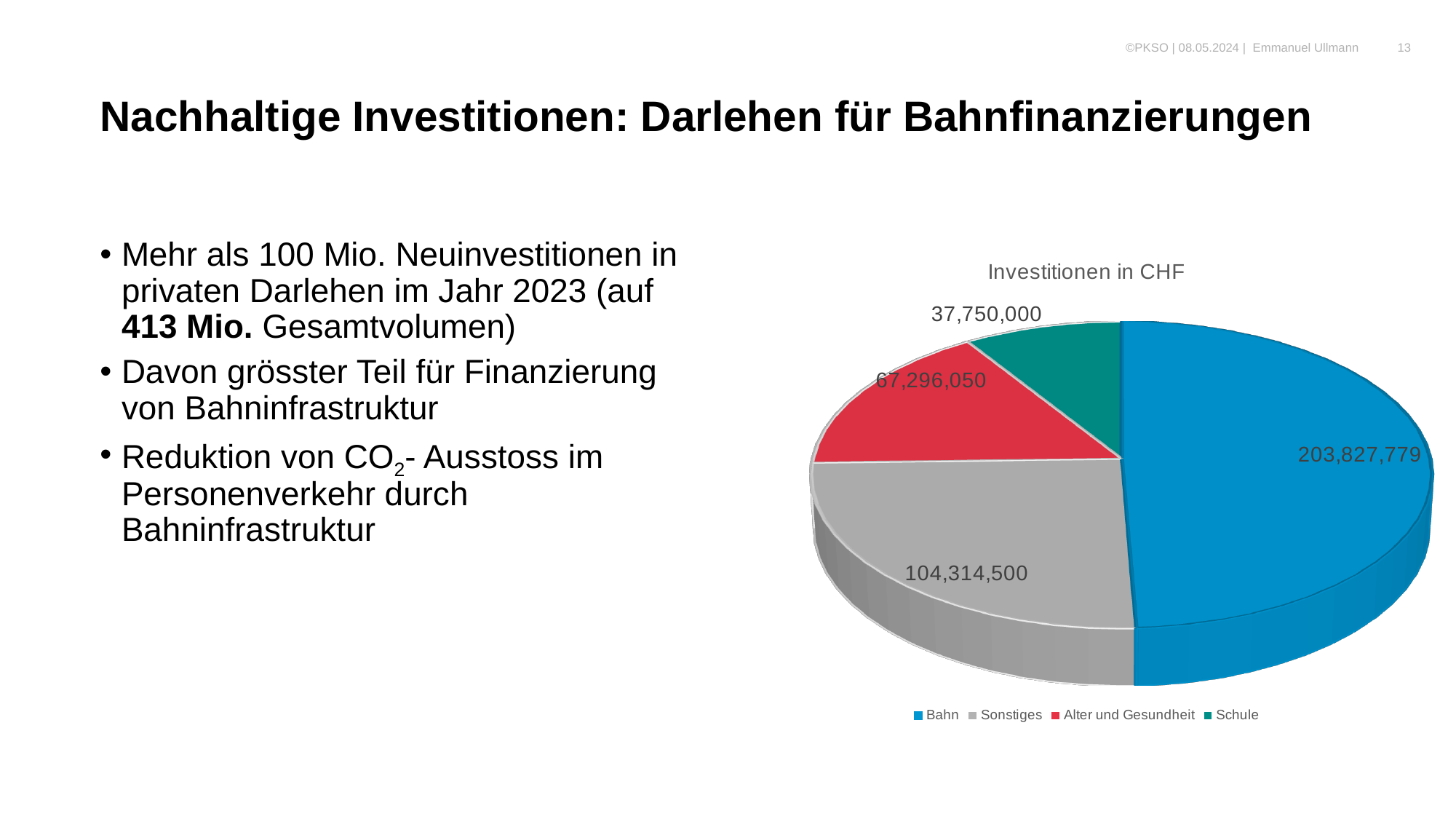
What is the difference between the values for Bahn and Sonstiges? 99,513,279 Which category has the largest slice in the pie chart? Bahn What is the value for Sonstiges in the pie chart? 104,314,500 What type of chart is shown on the slide? Pie chart Which category has the smallest slice in the pie chart? Schule What is the value for Schule in the pie chart? 37,750,000 Which is larger, the value for Alter und Gesundheit or the value for Schule? Alter und Gesundheit What is the value for Alter und Gesundheit in the pie chart? 67,296,050 How many categories does the pie chart show? 4 Which colour represents Alter und Gesundheit in the legend? Red What is the value for Bahn in the pie chart? 203,827,779 What is the title of the chart? Investitionen in CHF